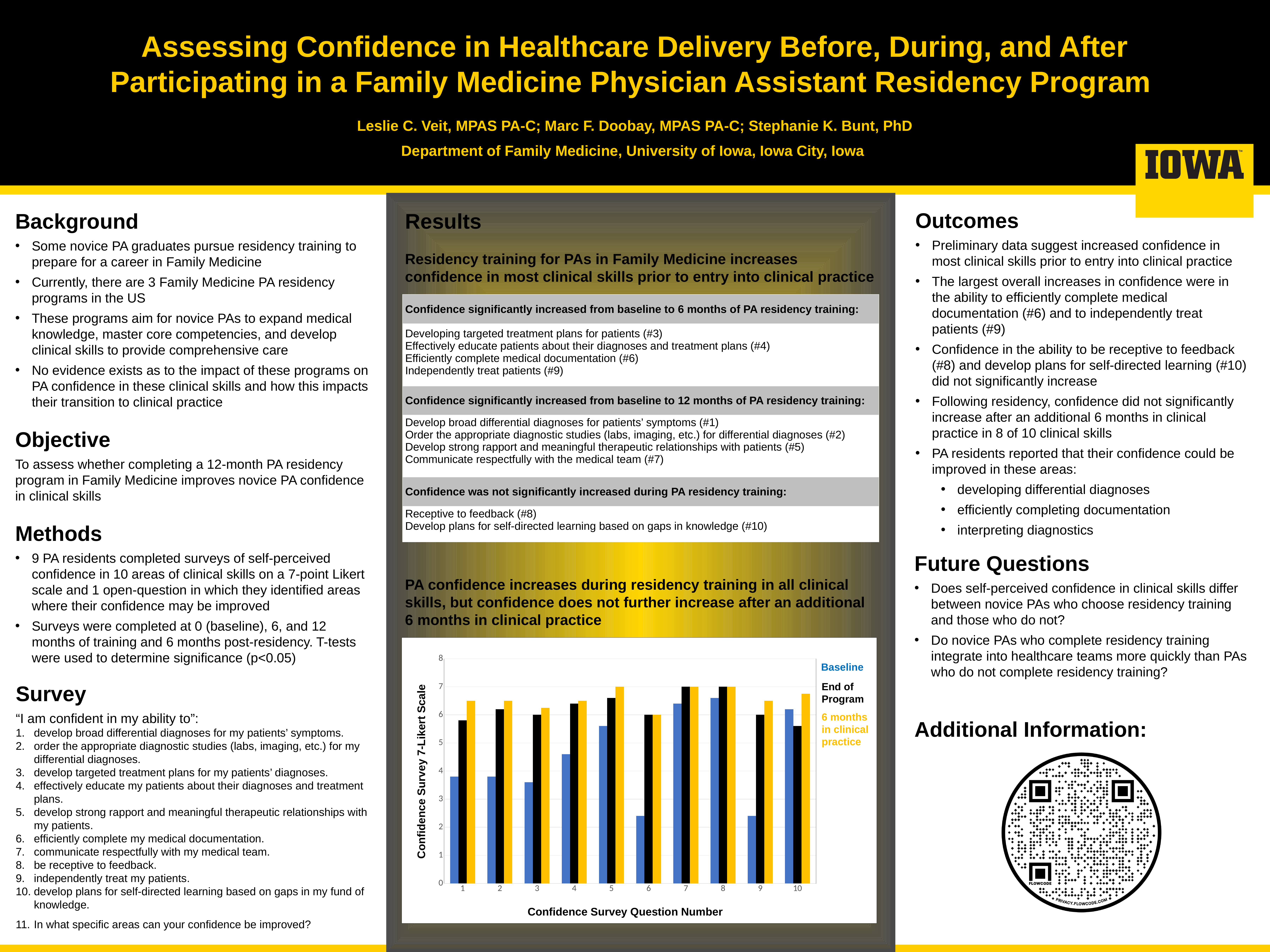
Is the Baseline value for question 8 greater or less than 6? greater Is the Baseline value for question 9 greater or less than 3? less What is the label of the chart's y axis? Confidence Survey 7-Likert Scale For question 10, which is larger: the End of Program value or the 6 months in clinical practice value? 6 months in clinical practice Is the End of Program value for question 1 greater or less than 5? greater For question 1, which is larger: the Baseline value or the End of Program value? End of Program For question 4, which is larger: the Baseline value or the 6 months in clinical practice value? 6 months in clinical practice How many question numbers are shown along the x axis of the chart? 10 Which series is shown in yellow in the chart? 6 months in clinical practice How many series does the chart's legend list? 3 What kind of chart is shown on the slide? bar chart